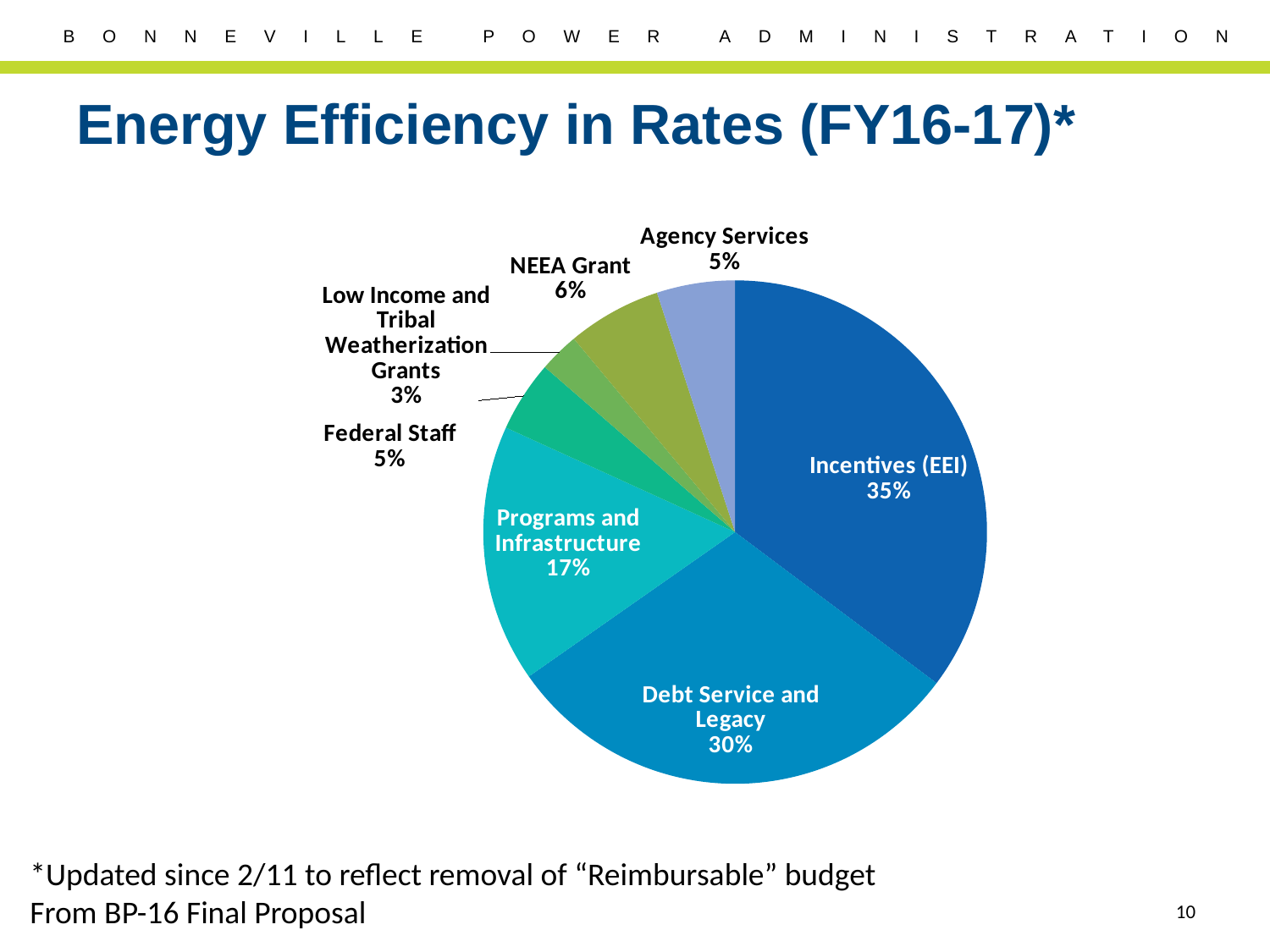
What is the difference between the shares for Incentives (EEI) and Debt Service and Legacy? 5% Which category has the smallest slice of the pie? Low Income and Tribal Weatherization Grants What is the value shown for NEEA Grant? 6% What share of the pie does Debt Service and Legacy represent? 30% What is the value shown for Low Income and Tribal Weatherization Grants? 3% What share of the pie does Incentives (EEI) represent? 35% What kind of chart is shown on the slide? pie chart Which category has the largest slice of the pie? Incentives (EEI) What is the title of the chart on the slide? Energy Efficiency in Rates (FY16-17)* How many categories are shown in the pie chart? 7 Which is larger, the share for NEEA Grant or the share for Federal Staff? NEEA Grant What is the value shown for Programs and Infrastructure? 17%